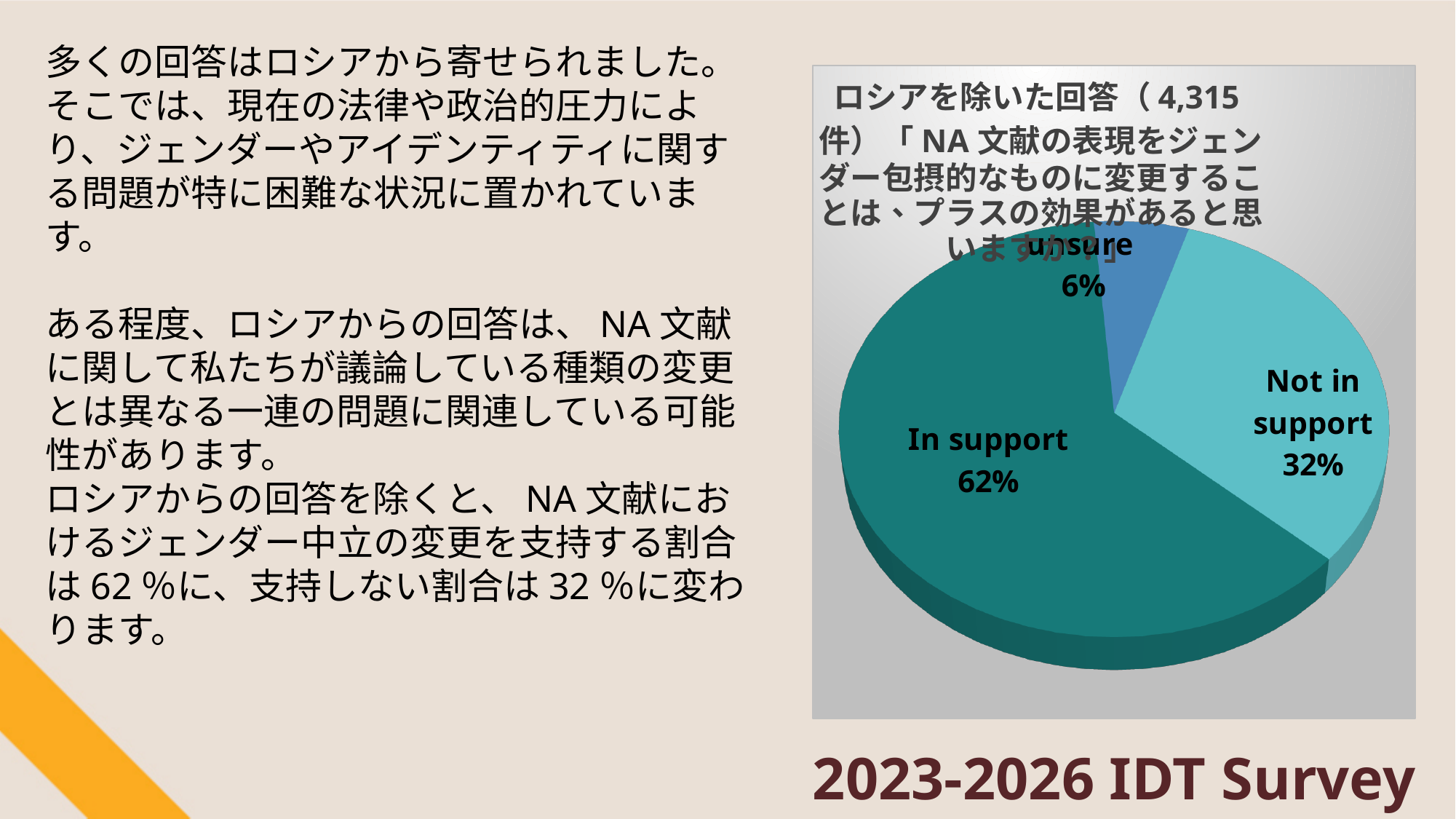
What is the difference in percentage points between the "In support" and "Not in support" slices? 30 How many responses does the chart title say were counted, excluding Russia? 4,315 How many slices does the pie chart have? 3 Which slice of the pie chart is the smallest? unsure What kind of chart is shown on the slide? pie chart Which slice of the pie chart is the largest? In support Which is larger in the pie chart, "Not in support" or "unsure"? Not in support What percentage of the pie chart is labelled "In support"? 62% What percentage of the pie chart is labelled "unsure"? 6% What percentage of the pie chart is labelled "Not in support"? 32% What colour is the "In support" slice of the pie chart? dark teal What is the combined share of the "Not in support" and "unsure" slices? 38%